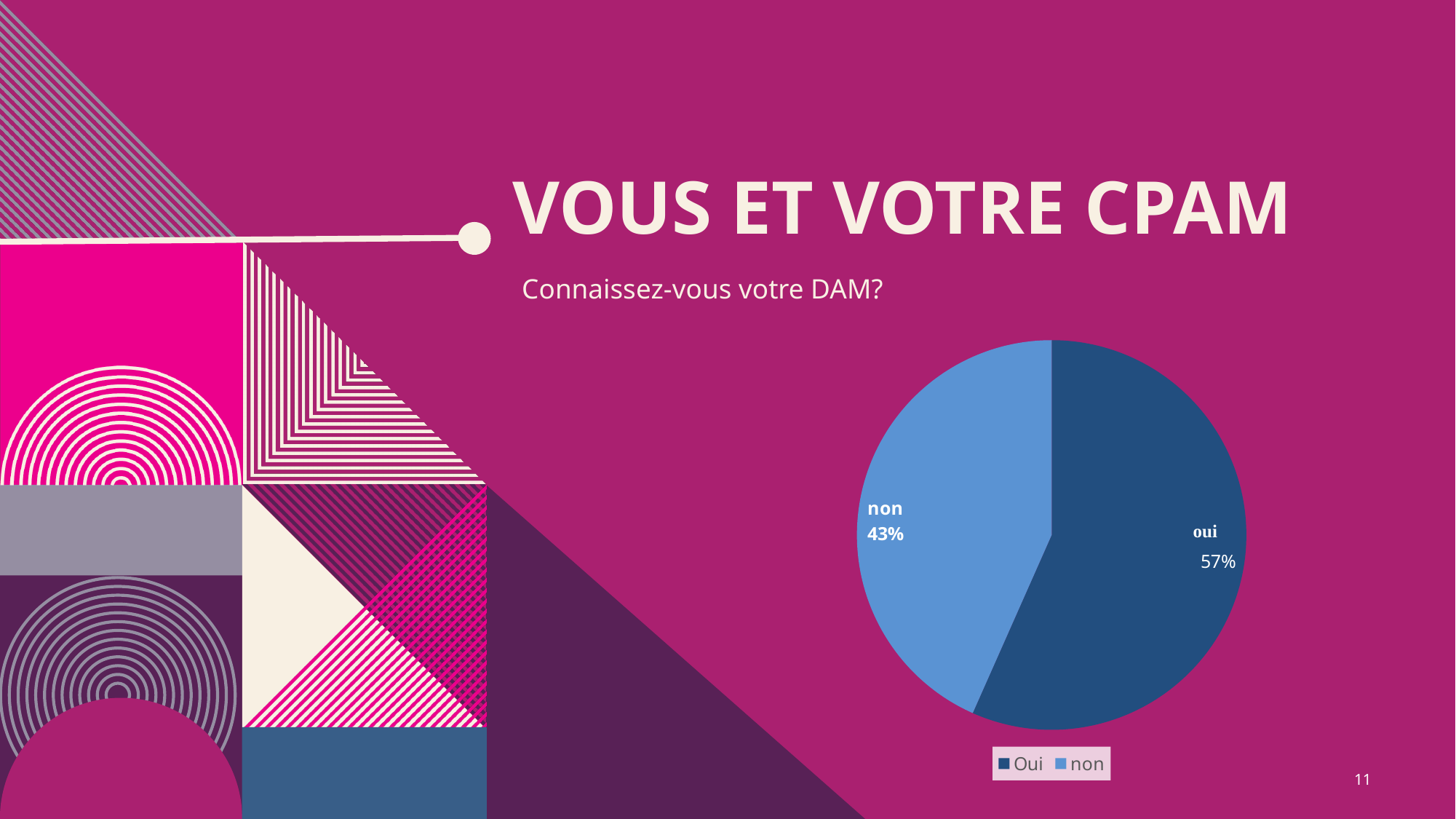
What is the difference in percentage points between the "oui" and "non" slices? 14 Which legend entry is shown in the lighter blue colour? non What kind of chart is shown on the slide? pie chart Which slice is the largest in the pie chart? oui How many slices does the pie chart have? 2 Which is larger, the "oui" slice or the "non" slice? oui What question does the pie chart answer, according to the text above it? Connaissez-vous votre DAM? What share of the pie does the "oui" slice represent? 57% Which slice is the smallest in the pie chart? non How many entries does the legend list? 2 What share of the pie does the "non" slice represent? 43%